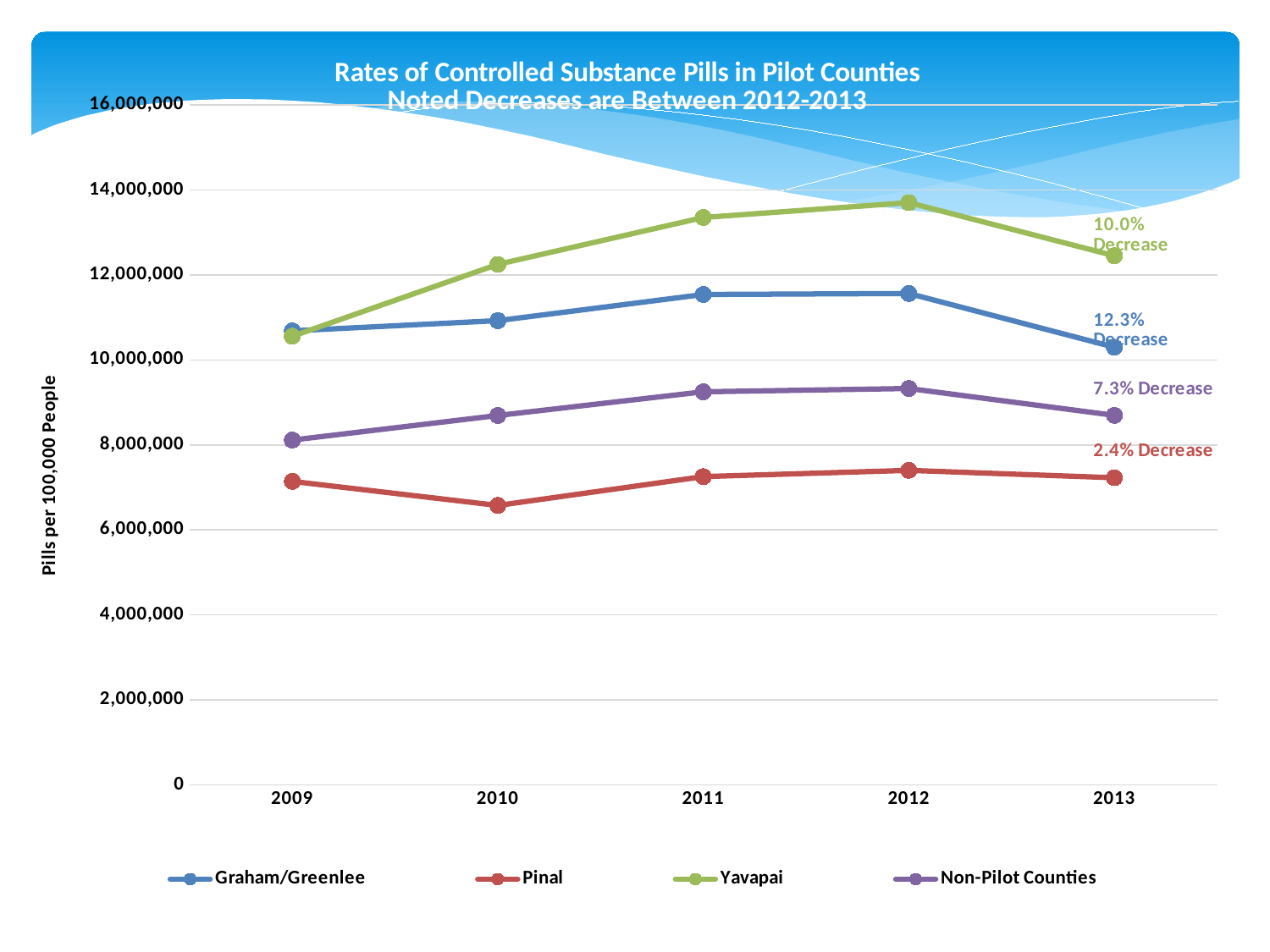
Is the value for Yavapai in 2012 greater or less than 12,000,000? greater What is the label on the y axis? Pills per 100,000 People Which series has the lowest value in 2010? Pinal How many years are plotted along the x axis? 5 Which series has the highest value in 2012? Yavapai Which is larger in 2011, the value for Non-Pilot Counties or the value for Pinal? Non-Pilot Counties How many series does the legend list? 4 Does the Yavapai line rise or fall from 2009 to 2012? Rise Is the value for Graham/Greenlee in 2011 greater or less than 10,000,000? greater What kind of chart is shown on the slide? Line chart What percentage decrease is noted for Graham/Greenlee between 2012 and 2013? 12.3% Decrease Is the value for Pinal in 2010 greater or less than 8,000,000? less